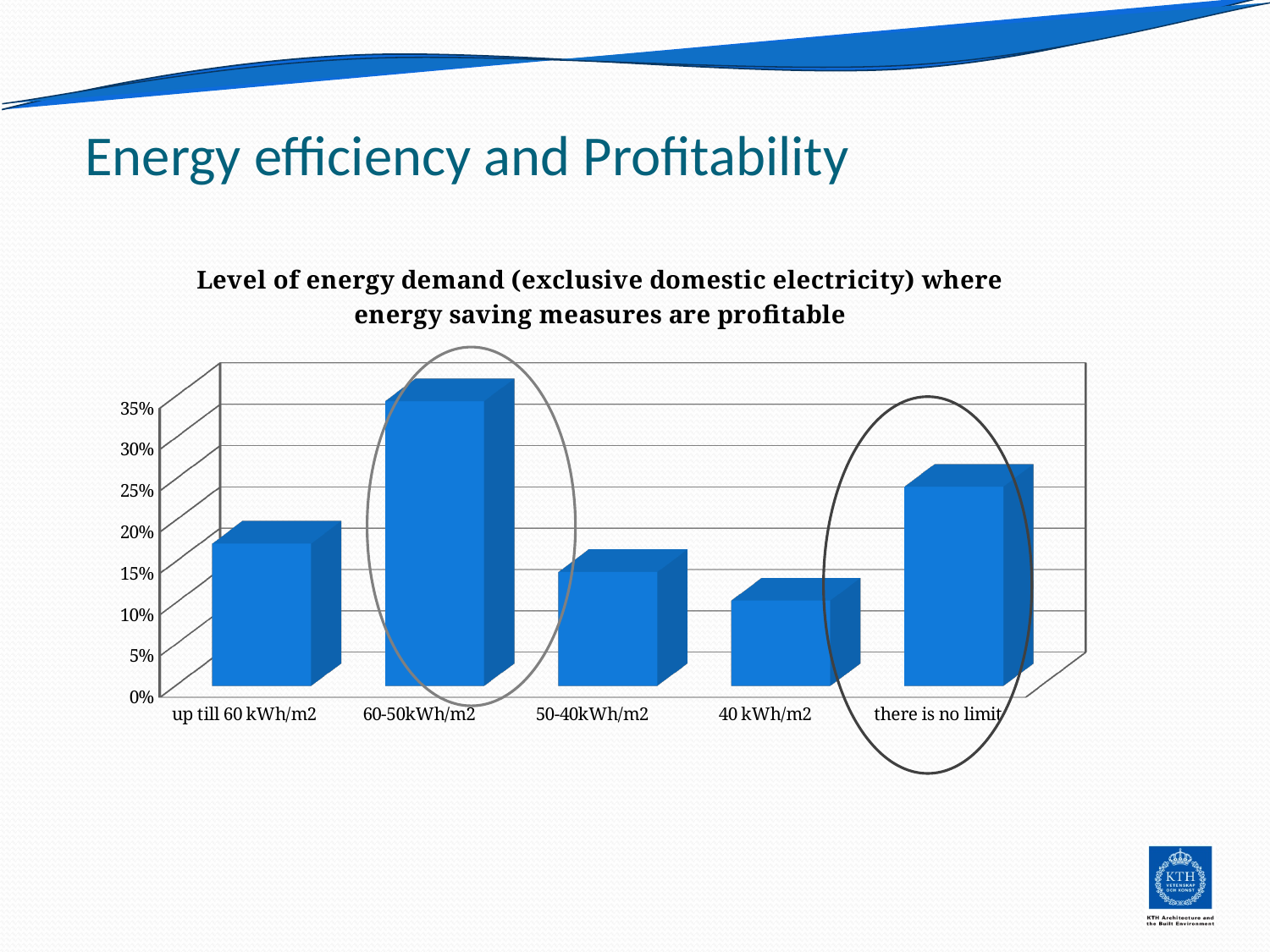
Is the value for 50-40kWh/m2 greater or less than 20%? less What is the title of the chart? Level of energy demand (exclusive domestic electricity) where energy saving measures are profitable Which category has the lowest value in the chart? 40 kWh/m2 Which is larger, the value for up till 60 kWh/m2 or the value for 40 kWh/m2? up till 60 kWh/m2 What kind of chart is shown on the slide? bar chart Is the value for 60-50kWh/m2 greater or less than 30%? greater How many categories are shown on the x axis of the chart? 5 Is the value for there is no limit greater or less than 20%? greater Which is larger, the value for 60-50kWh/m2 or the value for there is no limit? 60-50kWh/m2 Which category has the highest value in the chart? 60-50kWh/m2